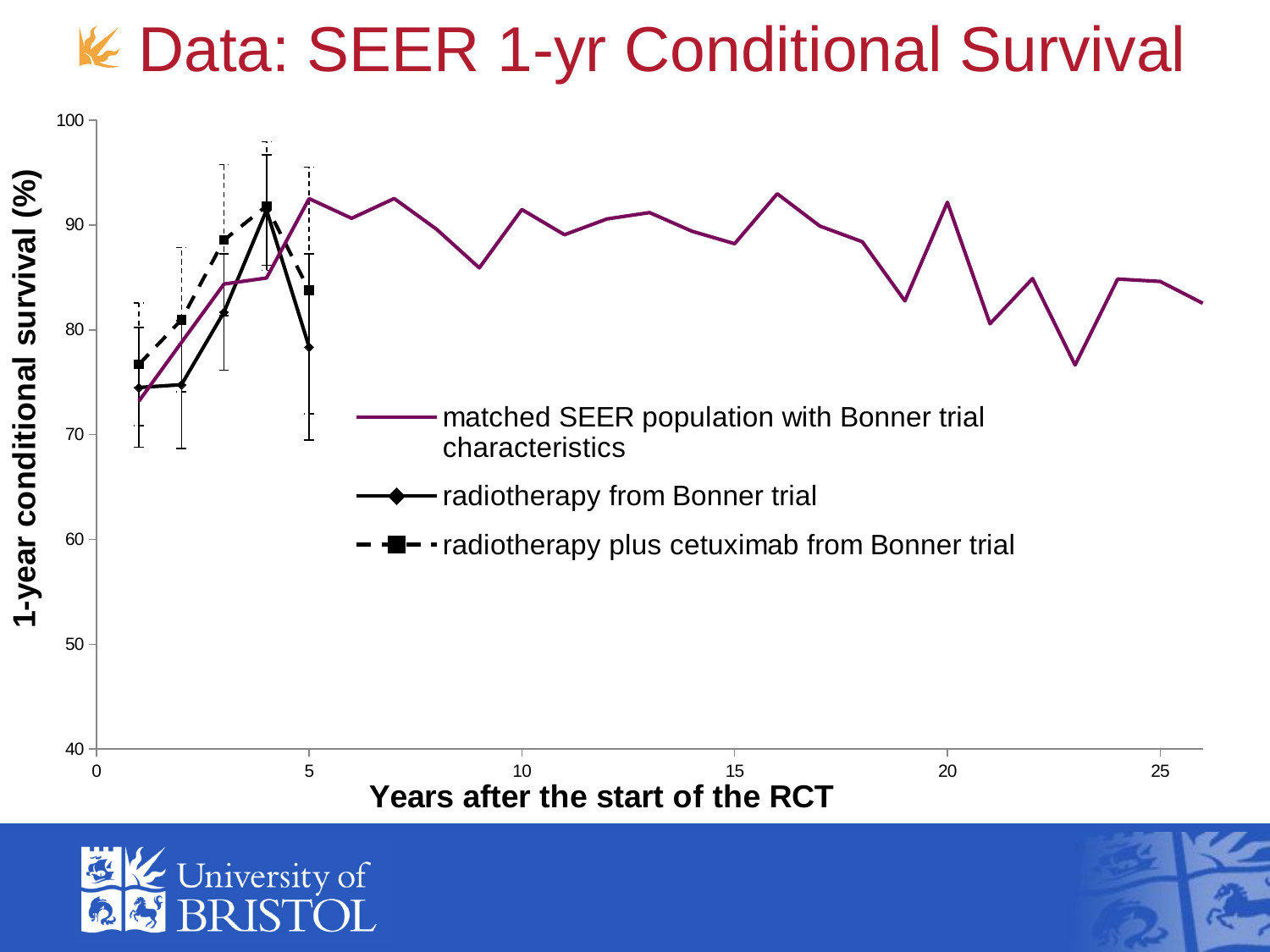
How many data points are plotted for the 'radiotherapy from Bonner trial' series? 5 What is the title of the y axis? 1-year conditional survival (%) At year 5, which series has the larger value: 'radiotherapy from Bonner trial' or 'radiotherapy plus cetuximab from Bonner trial'? radiotherapy plus cetuximab from Bonner trial Is the value for 'radiotherapy from Bonner trial' at year 1 greater or less than 80? less Is the value for 'radiotherapy plus cetuximab from Bonner trial' at year 5 greater or less than 80? greater What kind of chart is shown on the slide? line chart Is the value for 'matched SEER population with Bonner trial characteristics' at year 16 greater or less than 90? greater Does the 'radiotherapy from Bonner trial' series rise or fall from year 1 to year 4? rise How many series does the legend list? 3 What is the title of the x axis? Years after the start of the RCT At which year does the 'matched SEER population with Bonner trial characteristics' line reach its lowest value? 1